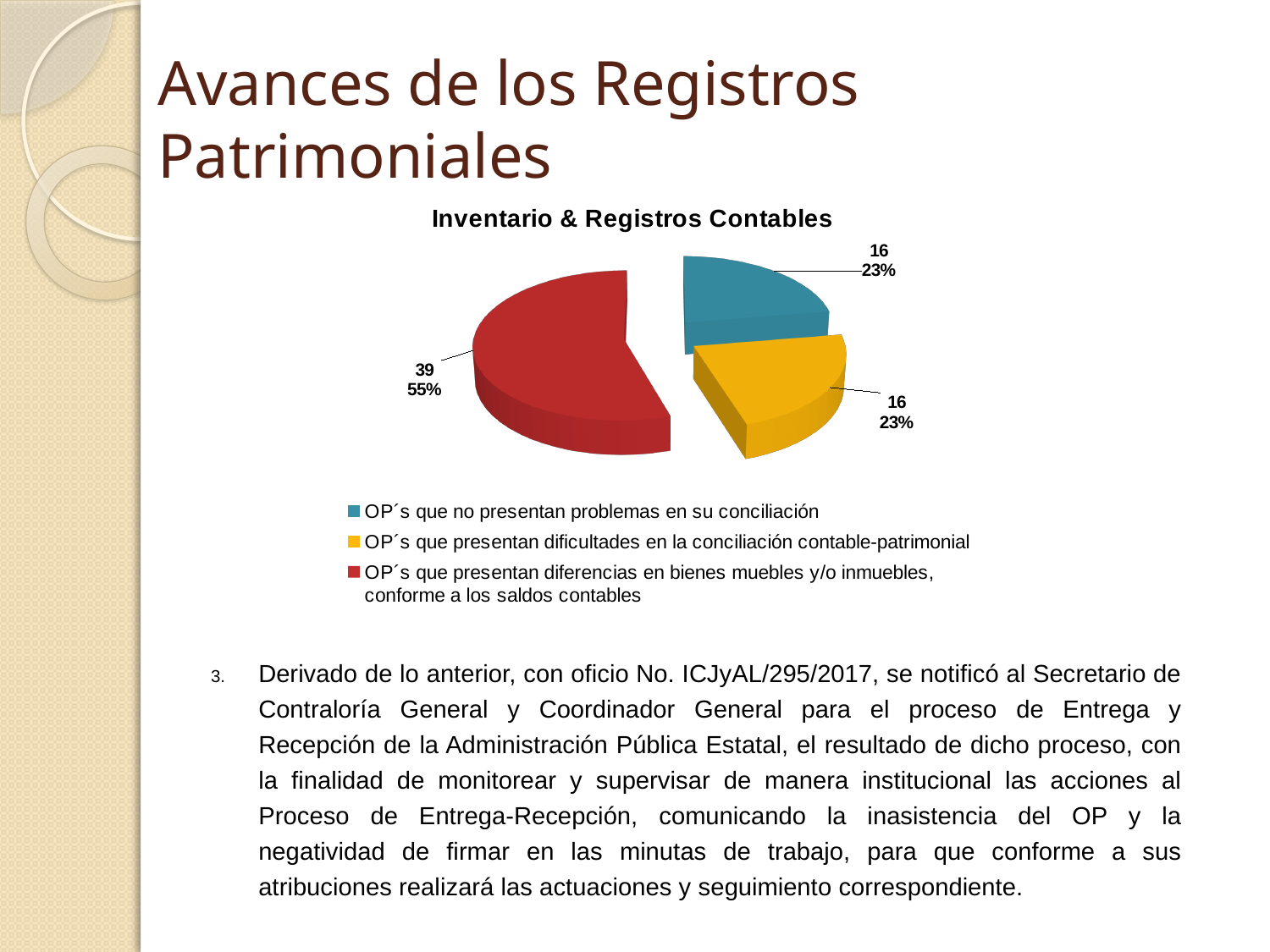
What percentage share does the slice for OP´s que presentan dificultades en la conciliación contable-patrimonial have? 23% Which category has the largest slice of the pie? OP´s que presentan diferencias en bienes muebles y/o inmuebles, conforme a los saldos contables How many slices does the pie chart have? 3 What is the total of all three values shown on the pie chart? 71 What is the difference between the value for OP´s que presentan diferencias en bienes muebles y/o inmuebles and the value for OP´s que no presentan problemas en su conciliación? 23 How many entries does the legend list? 3 What percentage share does the slice for OP´s que presentan diferencias en bienes muebles y/o inmuebles have? 55% Which is larger: the value for OP´s que presentan diferencias en bienes muebles y/o inmuebles or the value for OP´s que presentan dificultades en la conciliación contable-patrimonial? OP´s que presentan diferencias en bienes muebles y/o inmuebles What type of chart is shown on the slide? Pie chart What is the value for OP´s que no presentan problemas en su conciliación? 16 What is the title of the chart? Inventario & Registros Contables What is the value for OP´s que presentan diferencias en bienes muebles y/o inmuebles, conforme a los saldos contables? 39